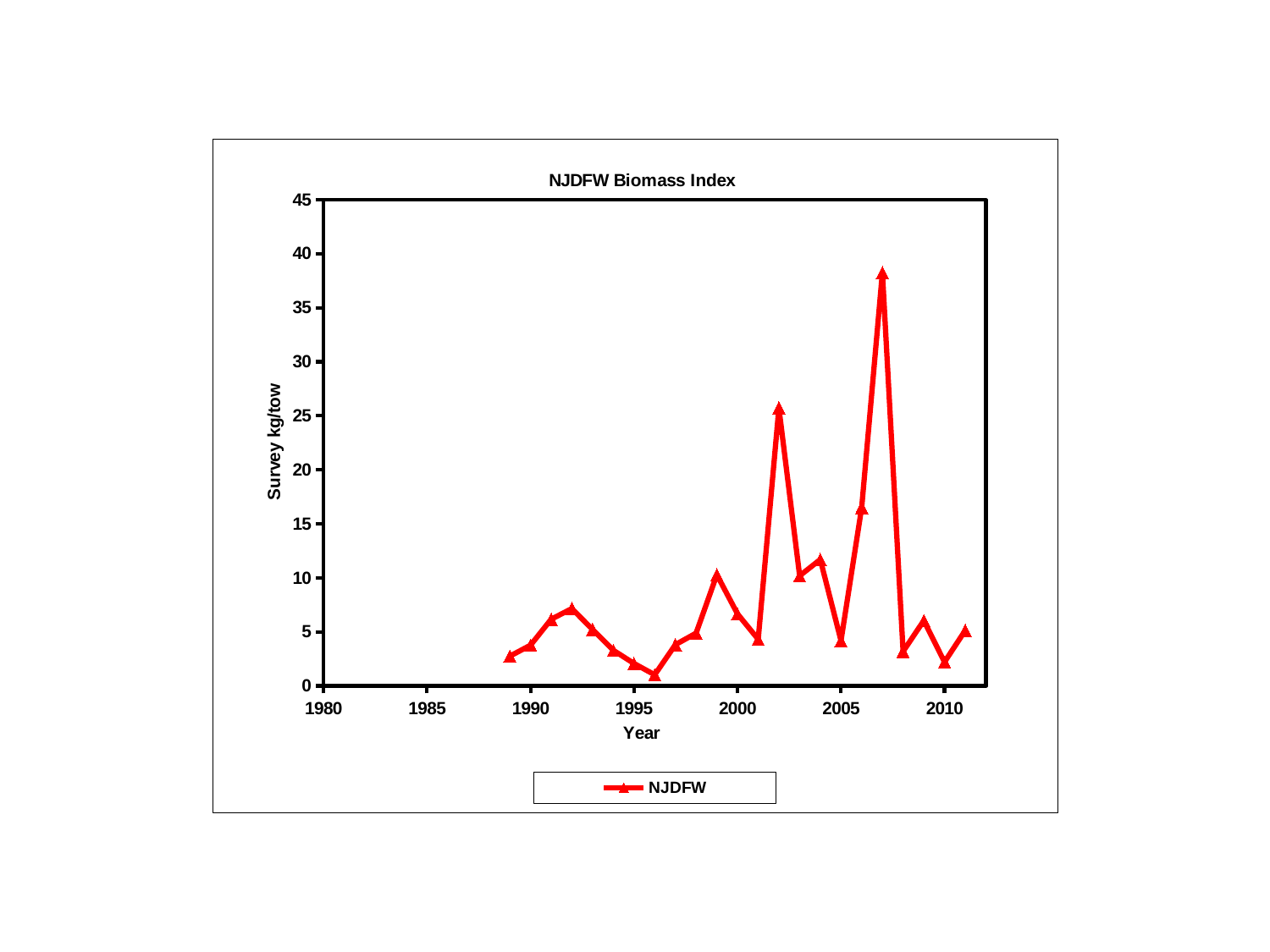
In which year does the NJDFW biomass index reach its lowest value? 1996 How many series does the legend list? 1 Is the value for 2006 greater or less than 15? greater What is the label of the y axis? Survey kg/tow Is the value for 1996 greater or less than 5? less Which year has the larger value, 2002 or 2007? 2007 What kind of chart is shown on the slide? line chart In which year does the NJDFW biomass index reach its highest value? 2007 Is the value for 2007 greater or less than 35? greater What is the title of the chart? NJDFW Biomass Index Which year has the larger value, 1999 or 2008? 1999